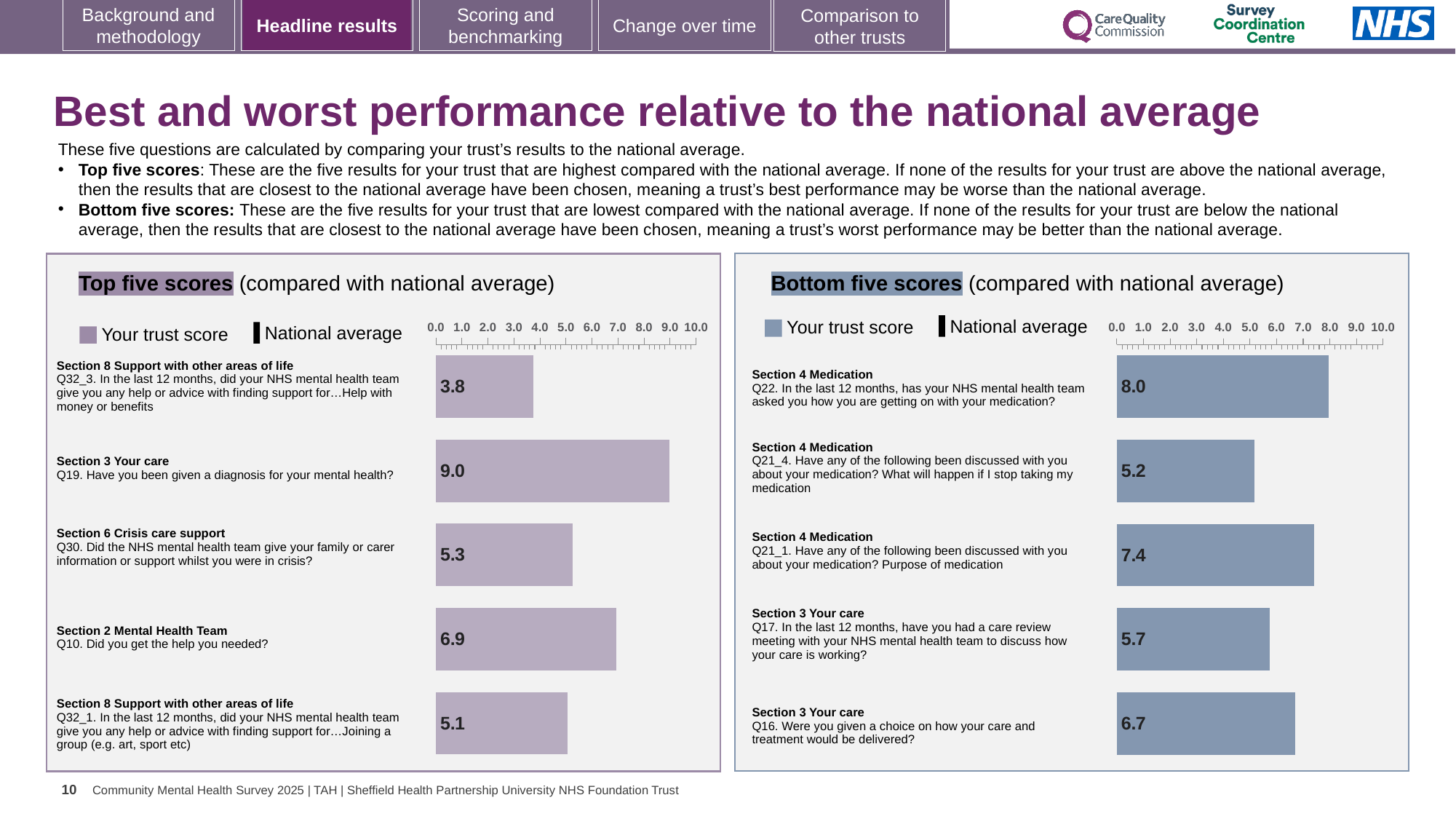
What type of chart is used in the Bottom five scores panel? Bar chart In the Bottom five scores chart, which question has the lowest trust score? Q21_4 (what will happen if I stop taking my medication) In the Top five scores chart, what is the difference between the trust scores for Q19 and Q32_3? 5.2 How many bars are plotted in the Top five scores chart? 5 In the Top five scores chart, what is the trust score for Q10 (Did you get the help you needed?)? 6.9 In the Top five scores chart, what is the trust score for Q19 (Have you been given a diagnosis for your mental health?)? 9.0 In the Bottom five scores chart, which has the larger trust score: Q21_1 (purpose of medication) or Q16 (choice on how your care and treatment would be delivered)? Q21_1 In the Bottom five scores chart, what is the difference between the trust scores for Q22 and Q17? 2.3 In the Top five scores chart, which question has the highest trust score? Q19. Have you been given a diagnosis for your mental health? In the Top five scores chart, which question has the lowest trust score? Q32_3 (help with money or benefits) In the Bottom five scores chart, what is the trust score for Q22 (has your NHS mental health team asked you how you are getting on with your medication?)? 8.0 In the Bottom five scores chart, which question has the highest trust score? Q22 (asked how you are getting on with your medication)